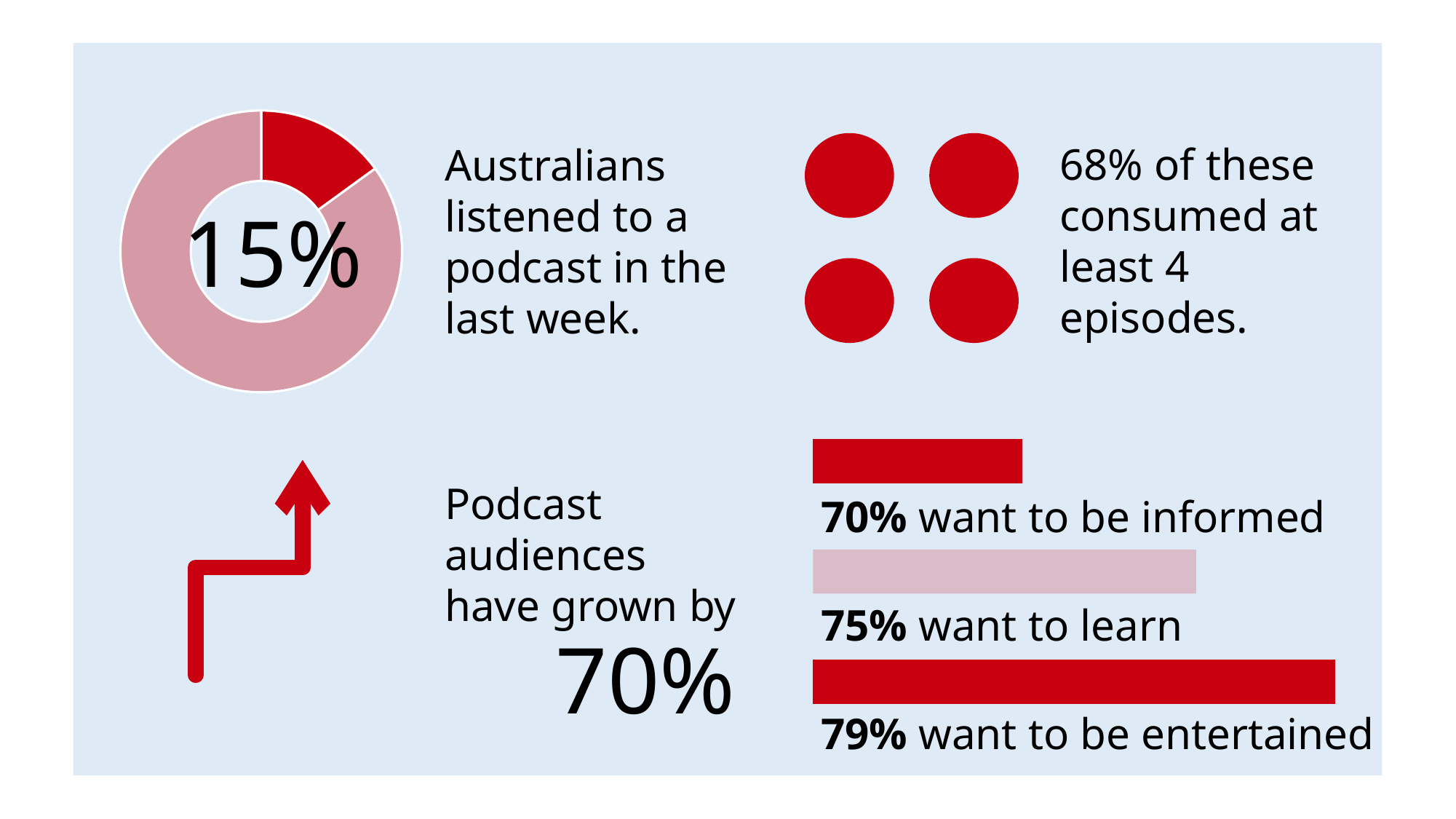
In the bar chart on the right, what percentage want to be entertained? 79% What kind of chart is the chart on the top left of the slide? donut chart How many bars are in the bar chart on the right? 3 In the donut chart on the left, what percentage of Australians listened to a podcast in the last week? 15% In the bar chart on the right, which is larger: the share who want to learn or the share who want to be informed? want to learn What kind of chart is the chart on the bottom right of the slide? bar chart In the bar chart on the right, what percentage want to be informed? 70% In the bar chart on the right, what is the difference between the share who want to be entertained and the share who want to be informed? 9 percentage points In the bar chart on the right, which category has the lowest value? want to be informed In the bar chart on the right, what percentage want to learn? 75% In the bar chart on the right, what colour is the bar for 'want to learn'? light pink In the bar chart on the right, which category has the highest value? want to be entertained